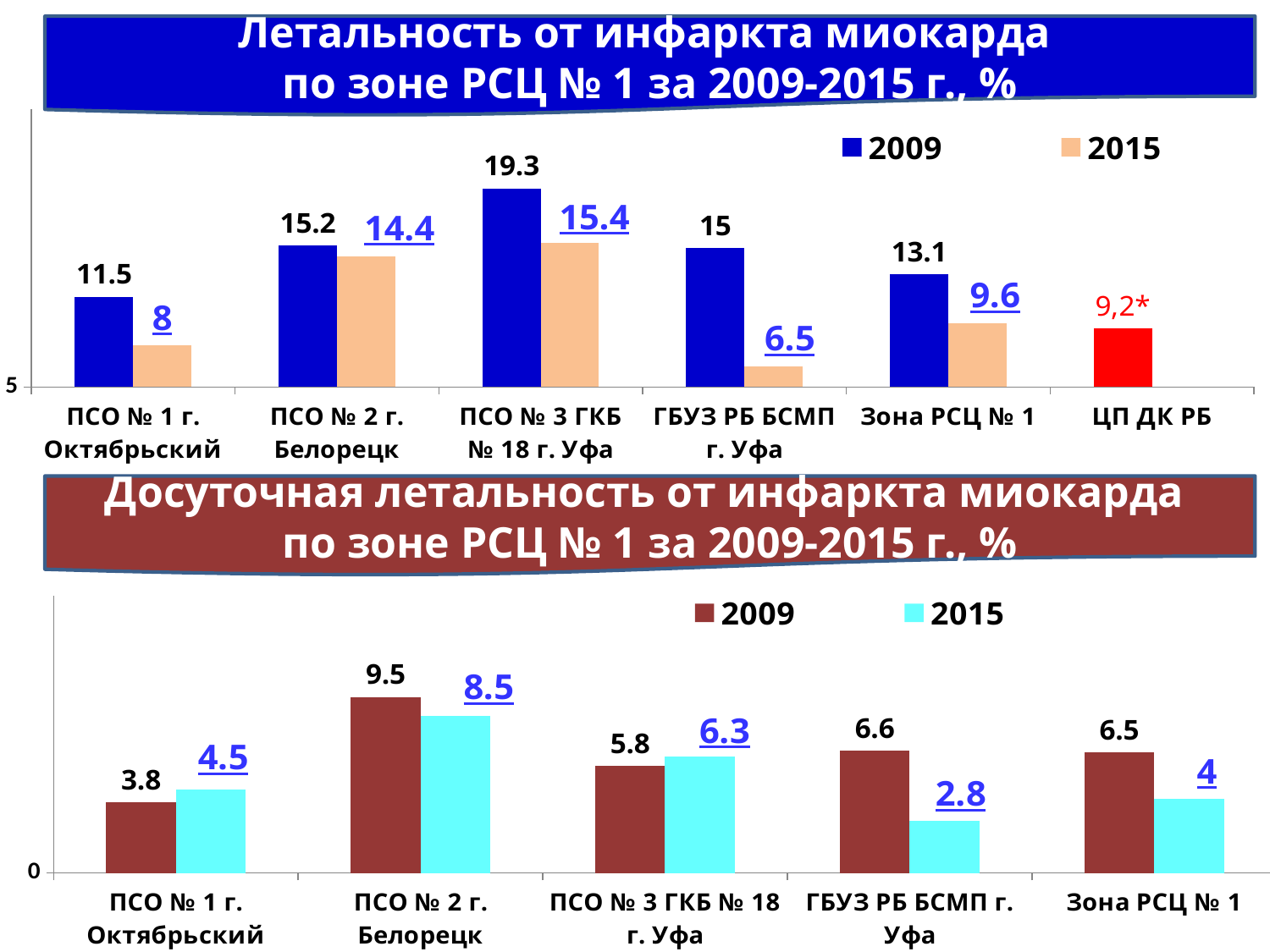
In the bottom chart (Досуточная летальность), what is the 2015 value for ПСО № 2 г. Белорецк? 8.5 In the bottom chart (Досуточная летальность), which category has the lowest 2015 value? ГБУЗ РБ БСМП г. Уфа In the top chart (Летальность от инфаркта миокарда), what is the 2015 value for ГБУЗ РБ БСМП г. Уфа? 6.5 What type of chart is the top chart (Летальность от инфаркта миокарда)? Bar chart How many categories are shown on the x axis of the bottom chart (Досуточная летальность)? 5 In the bottom chart (Досуточная летальность), which is larger for ПСО № 1 г. Октябрьский: the 2009 value or the 2015 value? 2015 In the bottom chart (Досуточная летальность), what is the difference between the 2009 and 2015 values for ГБУЗ РБ БСМП г. Уфа? 3.8 In the top chart (Летальность от инфаркта миокарда), which category has the lowest 2015 value? ГБУЗ РБ БСМП г. Уфа In the top chart (Летальность от инфаркта миокарда), what is the 2009 value for ПСО № 3 ГКБ № 18 г. Уфа? 19.3 In the top chart (Летальность от инфаркта миокарда), which category has the highest 2009 value? ПСО № 3 ГКБ № 18 г. Уфа In the top chart (Летальность от инфаркта миокарда), what value is shown for ЦП ДК РБ? 9,2* In the top chart (Летальность от инфаркта миокарда), what is the difference between the 2009 and 2015 values for Зона РСЦ № 1? 3.5